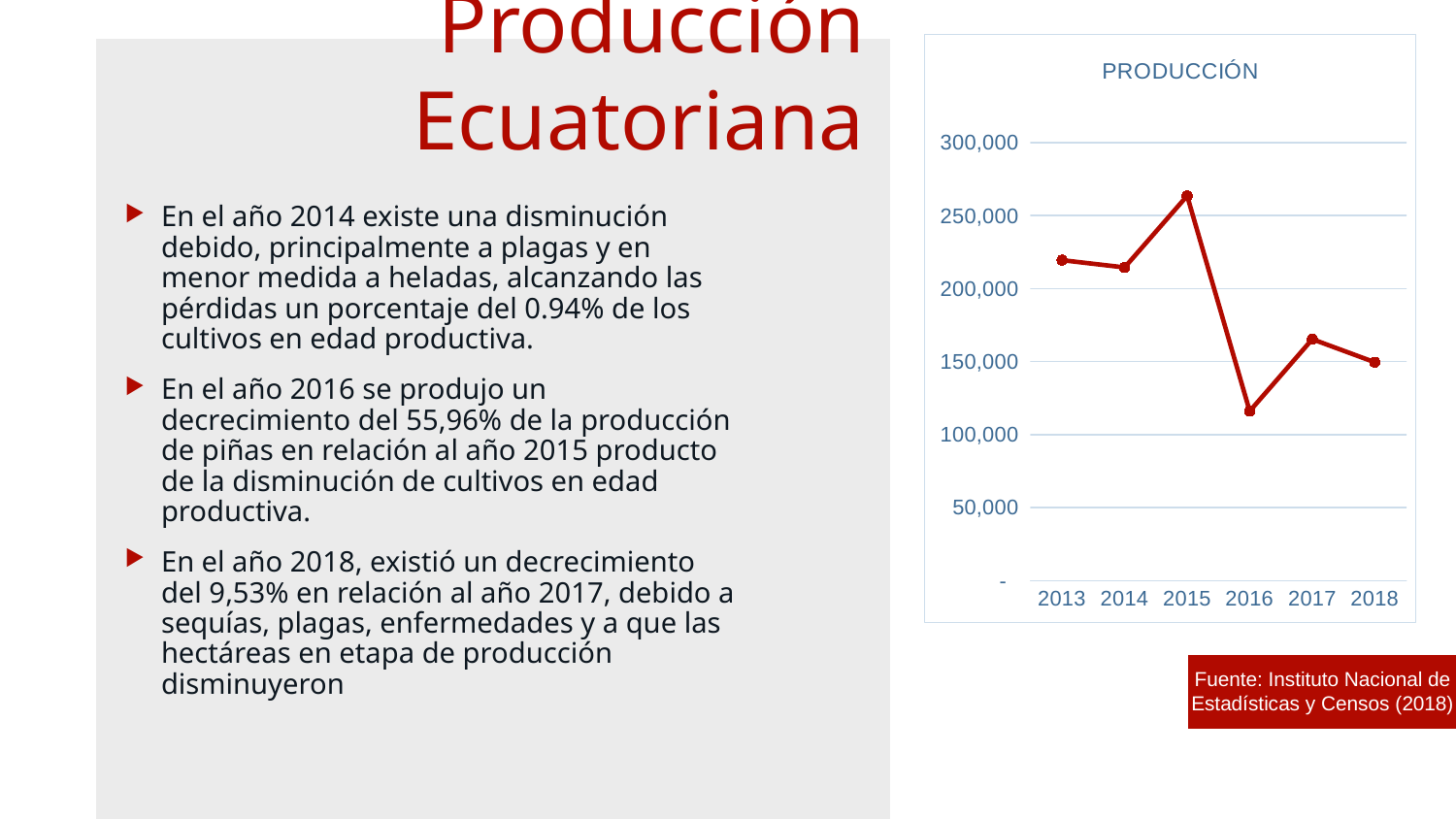
Is the value for 2015 greater or less than 250,000? greater Does the value rise or fall from 2015 to 2016? fall Which year has the larger value, 2015 or 2016? 2015 Is the value for 2016 greater or less than 150,000? less What is the title of the chart? PRODUCCIÓN Is the value for 2013 greater or less than 200,000? greater Which year has the highest value in the chart? 2015 Which year has the lowest value in the chart? 2016 What kind of chart is shown on the slide? line chart How many years are plotted on the x axis of the chart? 6 Which year has the larger value, 2013 or 2018? 2013